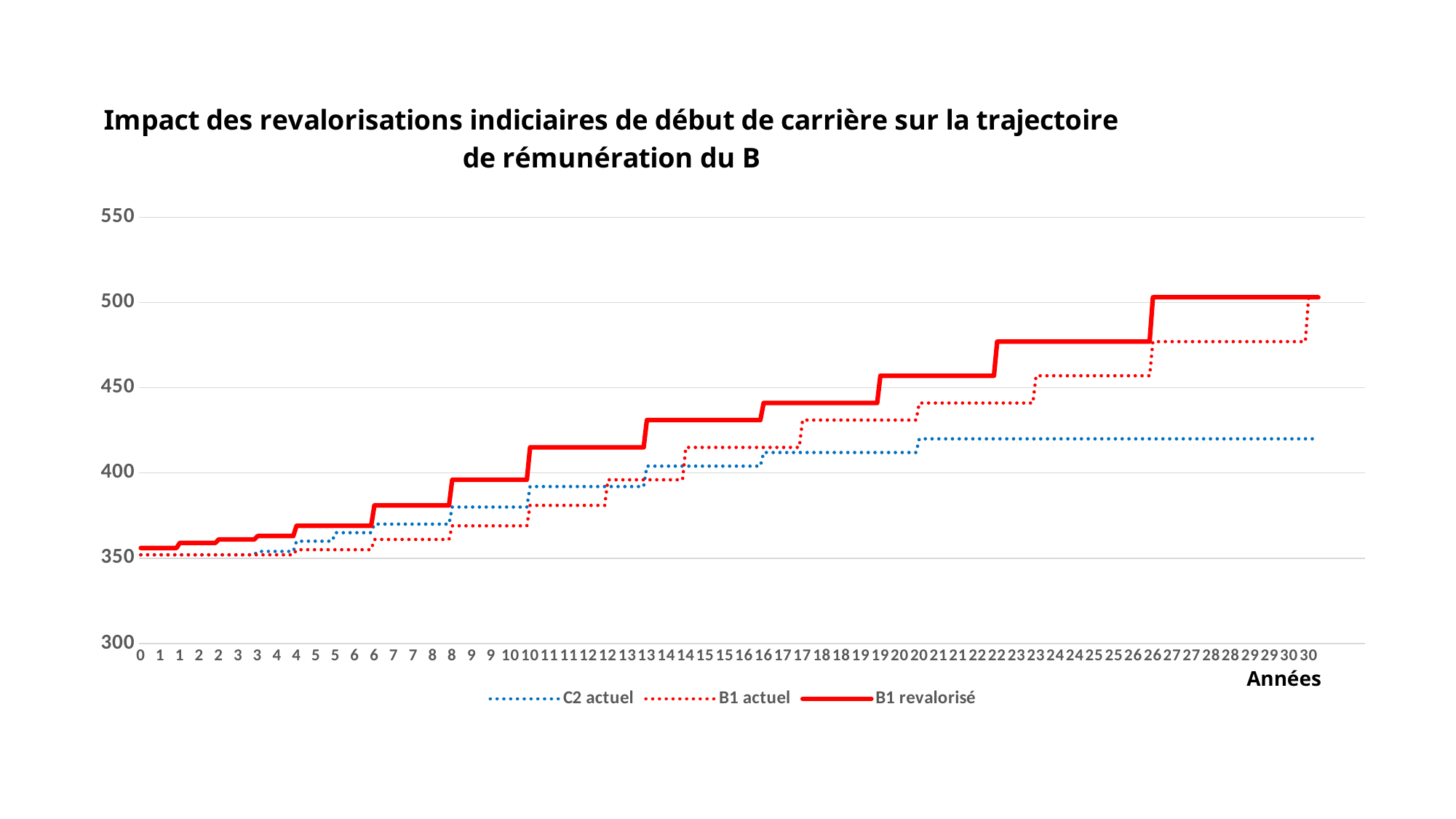
What kind of chart is shown on the slide? Line chart At year 30, which series has the higher value, C2 actuel or B1 revalorisé? B1 revalorisé Is the value for B1 actuel at year 5 greater or less than 400? less What is the title of the x axis? Années Is the value for B1 revalorisé at year 30 greater or less than 450? greater Is the value for C2 actuel at year 25 greater or less than 400? greater At year 20, which series has the higher value, B1 actuel or C2 actuel? B1 actuel Do the values of the B1 revalorisé series rise or fall as the years increase? Rise How many series does the legend list? 3 Which series is drawn as a solid line rather than a dotted line? B1 revalorisé